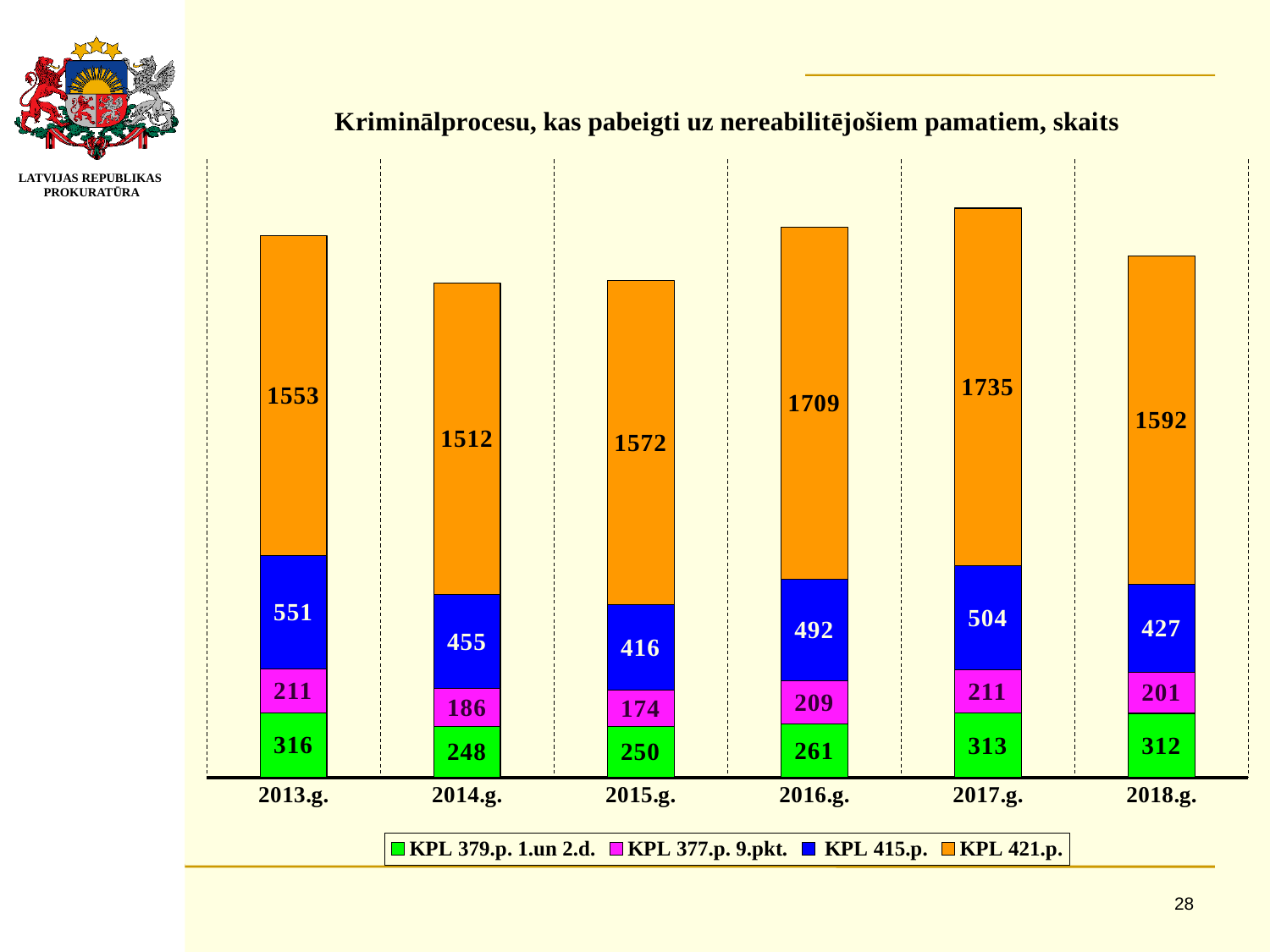
What is the value for KPL 415.p. in 2018.g.? 427 How many years are shown on the x axis? 6 In which year is the KPL 421.p. value the highest? 2017.g. Which is larger: the KPL 421.p. value in 2016.g. or in 2018.g.? 2016.g. In which year is the KPL 377.p. 9.pkt. value the lowest? 2015.g. What is the value for KPL 421.p. in 2017.g.? 1735 What is the value for KPL 379.p. 1.un 2.d. in 2014.g.? 248 What is the title of the chart? Kriminālprocesu, kas pabeigti uz nereabilitējošiem pamatiem, skaits What is the difference between the KPL 415.p. values in 2013.g. and 2014.g.? 96 How many series does the legend list? 4 What is the total of the stacked bar for 2017.g.? 2763 What type of chart is shown on the slide? Stacked bar chart